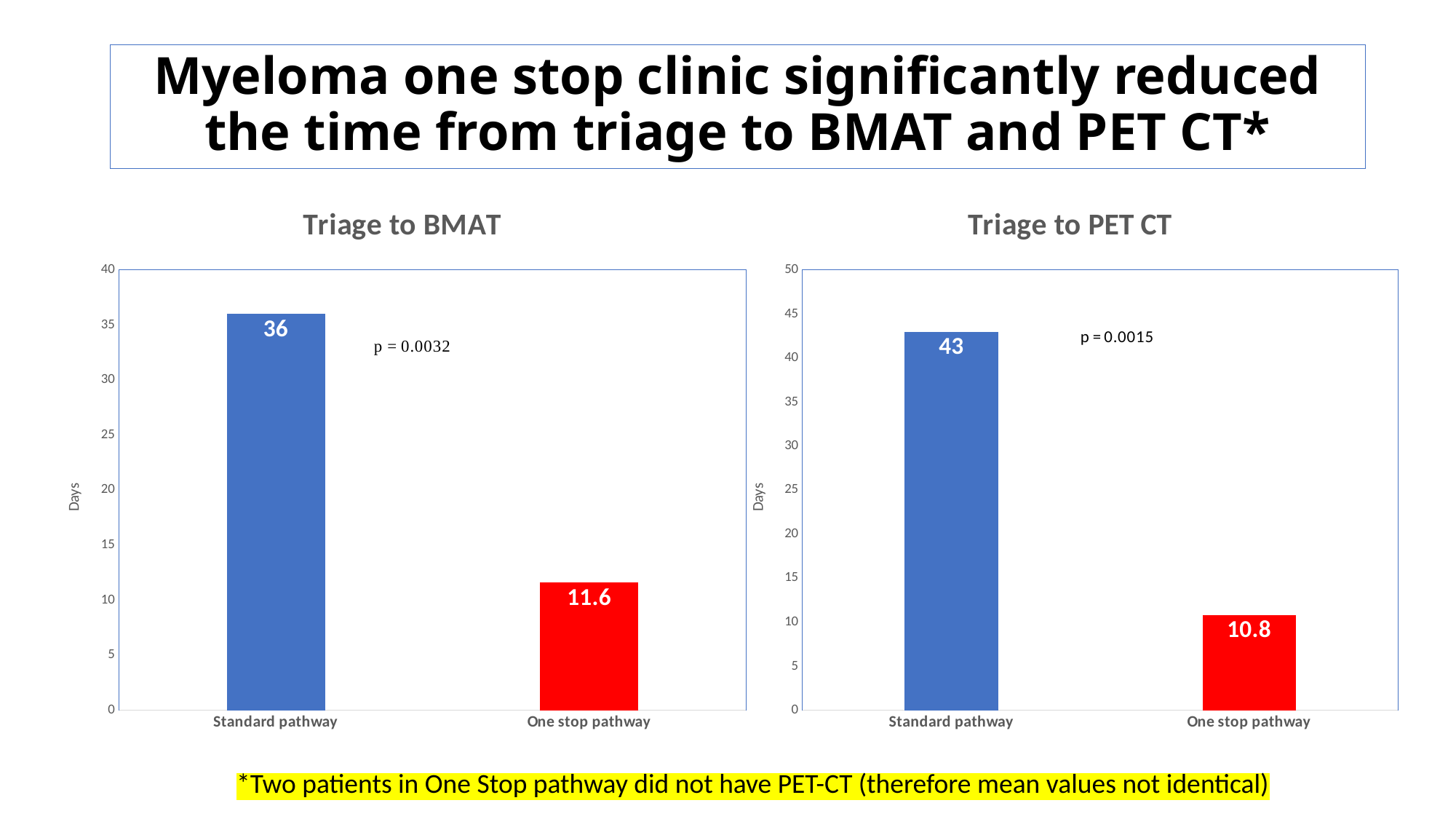
In the 'Triage to PET CT' chart, what is the value for One stop pathway? 10.8 In the 'Triage to PET CT' chart, which category has the lowest value? One stop pathway In the 'Triage to PET CT' chart, is the value for Standard pathway greater or less than 40? greater In the 'Triage to PET CT' chart, what is the difference between the Standard pathway and One stop pathway values? 32.2 In the 'Triage to PET CT' chart, what is the value for Standard pathway? 43 How many categories are shown in the 'Triage to BMAT' chart? 2 What is the y-axis label on the 'Triage to BMAT' chart? Days What kind of chart is the 'Triage to PET CT' chart? Bar chart In the 'Triage to BMAT' chart, what is the difference between the Standard pathway and One stop pathway values? 24.4 In the 'Triage to BMAT' chart, what is the value for Standard pathway? 36 In the 'Triage to BMAT' chart, which category has the highest value? Standard pathway In the 'Triage to BMAT' chart, what is the value for One stop pathway? 11.6